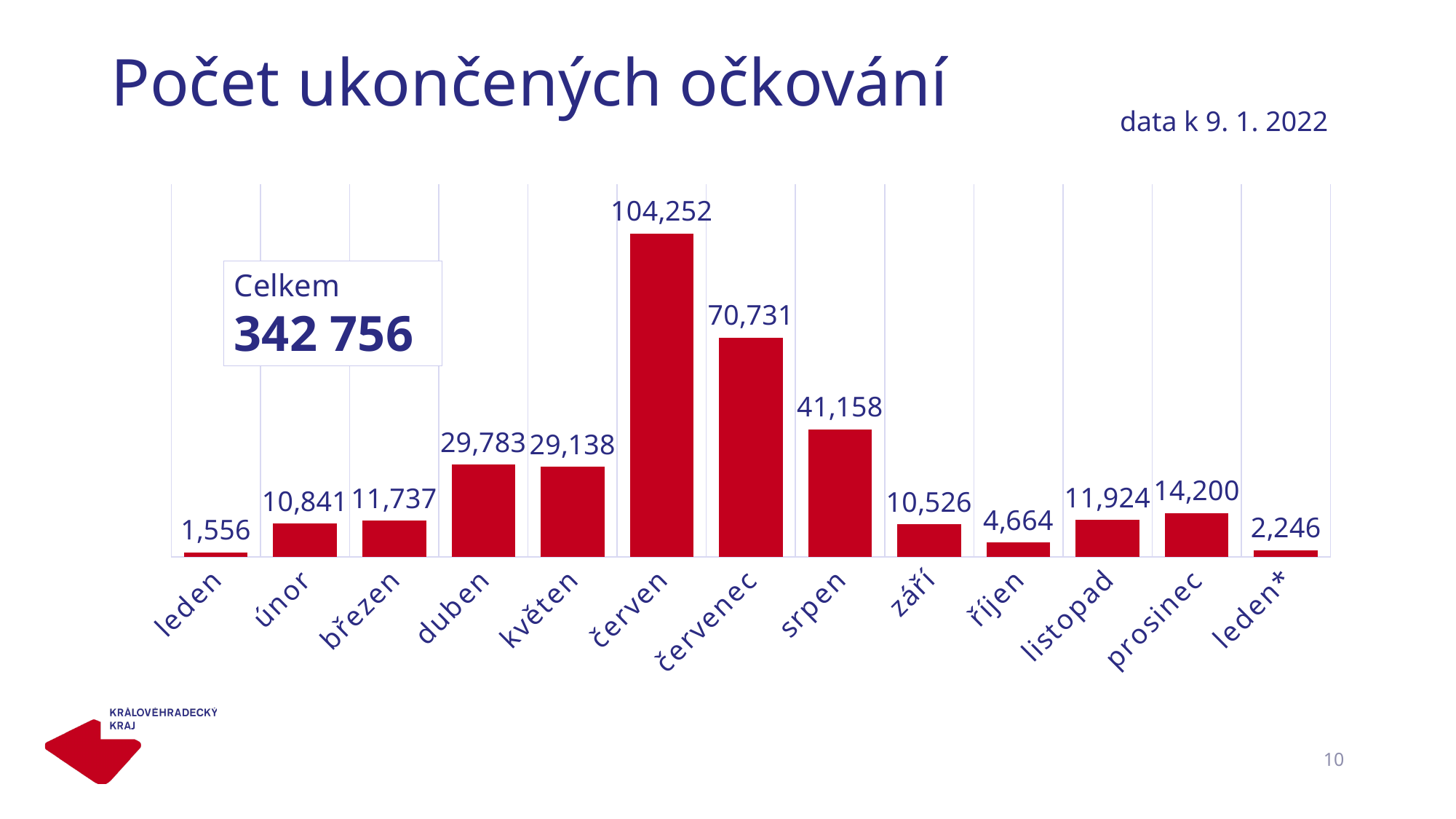
How many categories are shown on the x axis? 13 Which month has the highest value? červen What is the value for červen? 104,252 Which month has the lowest value? leden What is the difference between the values for červen and červenec? 33,521 What is the value for srpen? 41,158 What is the value for leden*? 2,246 What is the difference between the values for prosinec and listopad? 2,276 Which is larger, the value for duben or the value for květen? duben Which is larger, the value for září or the value for říjen? září What total (Celkem) is shown in the box on the chart? 342 756 What kind of chart is shown on the slide? bar chart